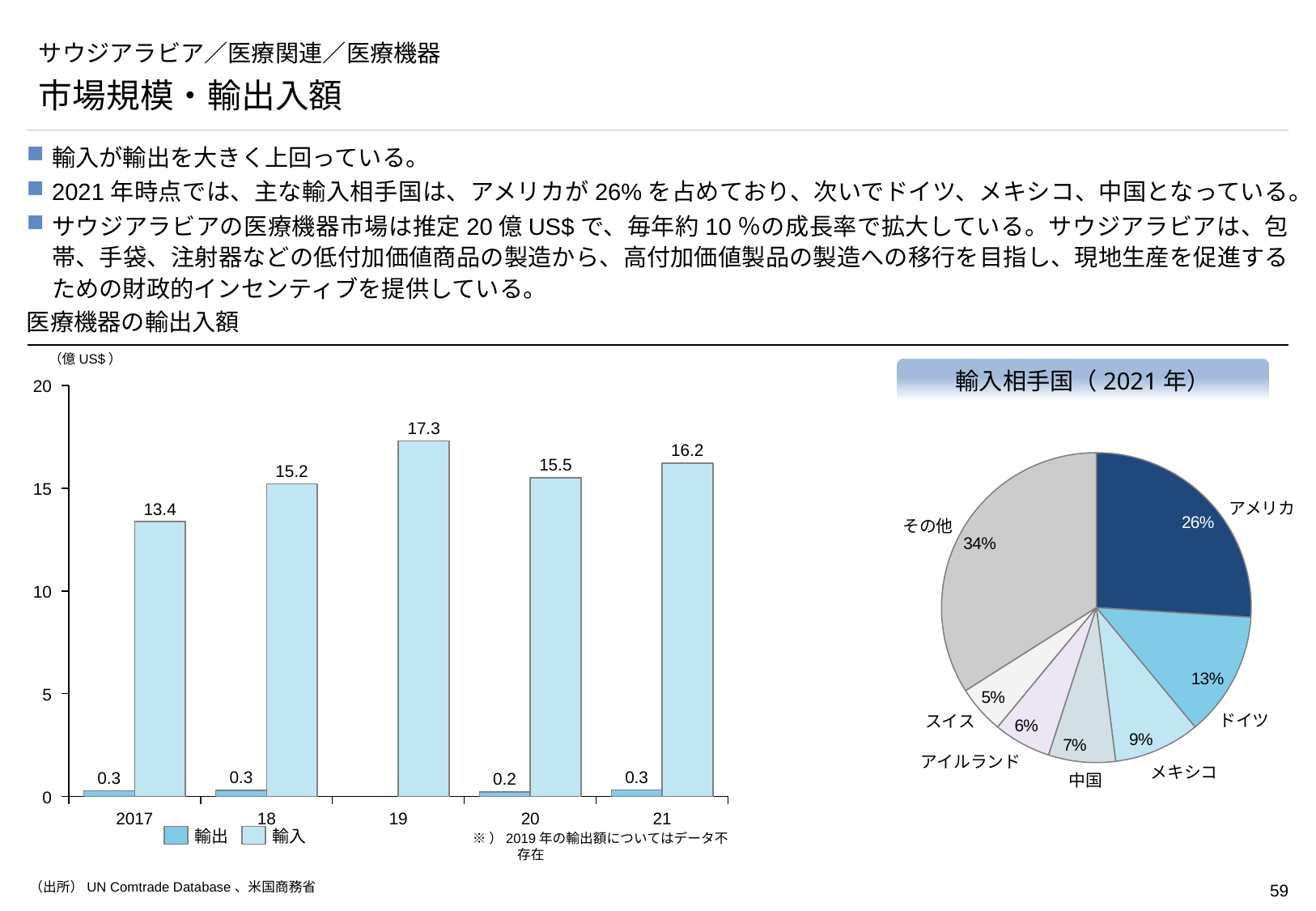
In the bar chart 医療機器の輸出入額, which year has the highest 輸入 value? 19 In the bar chart 医療機器の輸出入額, how many series does the legend list? 2 What kind of chart is 医療機器の輸出入額? bar chart In the bar chart 医療機器の輸出入額, what is the value of 輸出 for 20? 0.2 In the bar chart 医療機器の輸出入額, is the 輸入 value for 18 greater or less than 15? greater In the bar chart 医療機器の輸出入額, which year has the lowest 輸入 value? 2017 In the pie chart 輸入相手国（2021年）, which is larger, the share of ドイツ or the share of メキシコ? ドイツ In the pie chart 輸入相手国（2021年）, what share does アメリカ have? 26% In the pie chart 輸入相手国（2021年）, which named country (excluding その他) has the smallest share? スイス In the pie chart 輸入相手国（2021年）, how many slices are there? 7 In the bar chart 医療機器の輸出入額, what is the difference between the 輸入 values for 19 and 21? 1.1 In the bar chart 医療機器の輸出入額, what is the value of 輸入 for 2017? 13.4